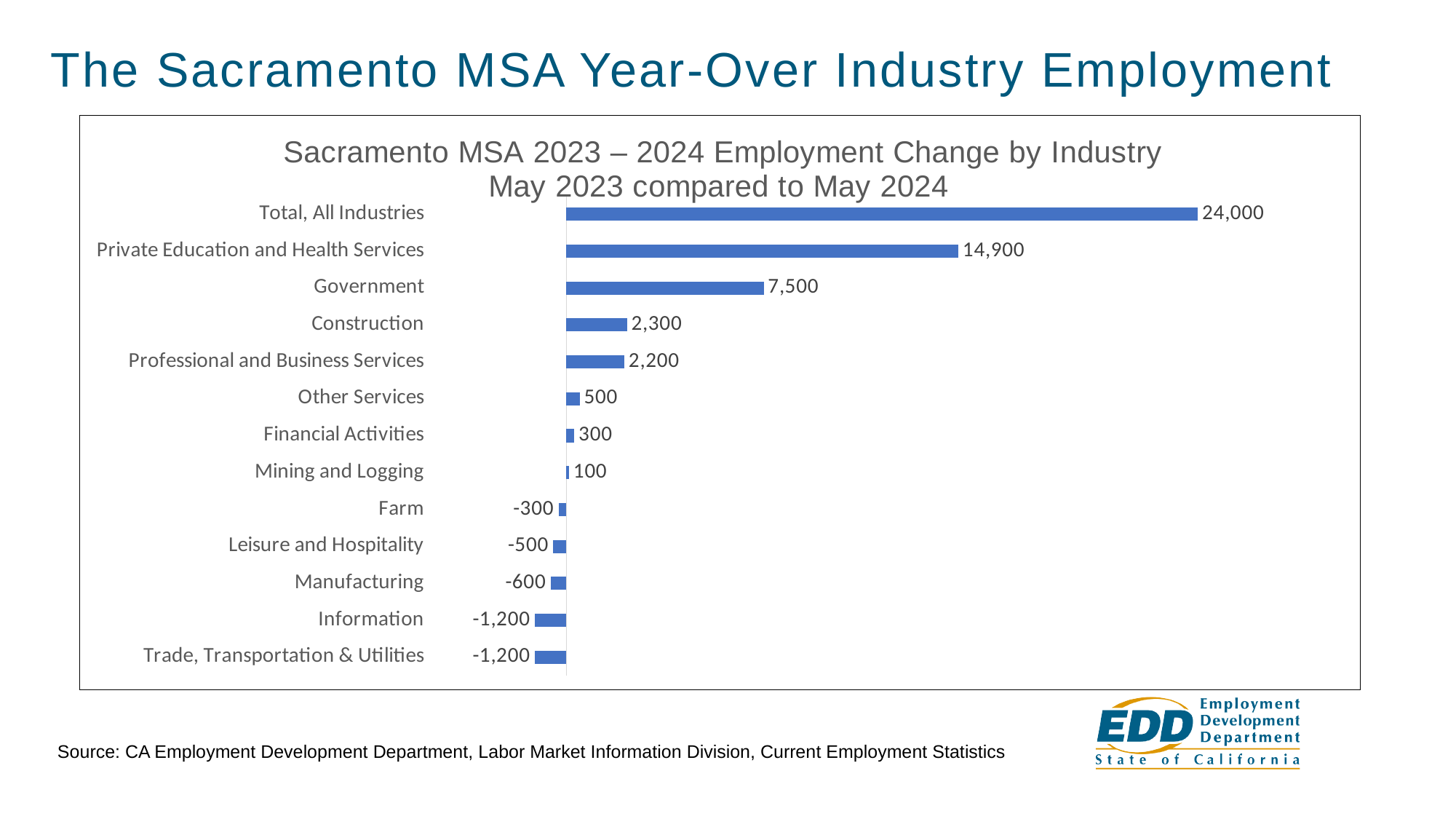
How many categories are shown on the chart? 13 Excluding Total, All Industries, which industry has the largest employment change? Private Education and Health Services What is the difference between the values for Private Education and Health Services and Government? 7,400 What is the employment change for Government? 7,500 What is the employment change for Mining and Logging? 100 What is the employment change for Manufacturing? -600 Which is larger, the value for Other Services or the value for Financial Activities? Other Services What kind of chart is shown on the slide? Bar chart What is the difference between the values for Construction and Professional and Business Services? 100 Which category has the highest value on the chart? Total, All Industries What is the employment change for Private Education and Health Services? 14,900 What is the title of the chart? Sacramento MSA 2023 – 2024 Employment Change by Industry May 2023 compared to May 2024